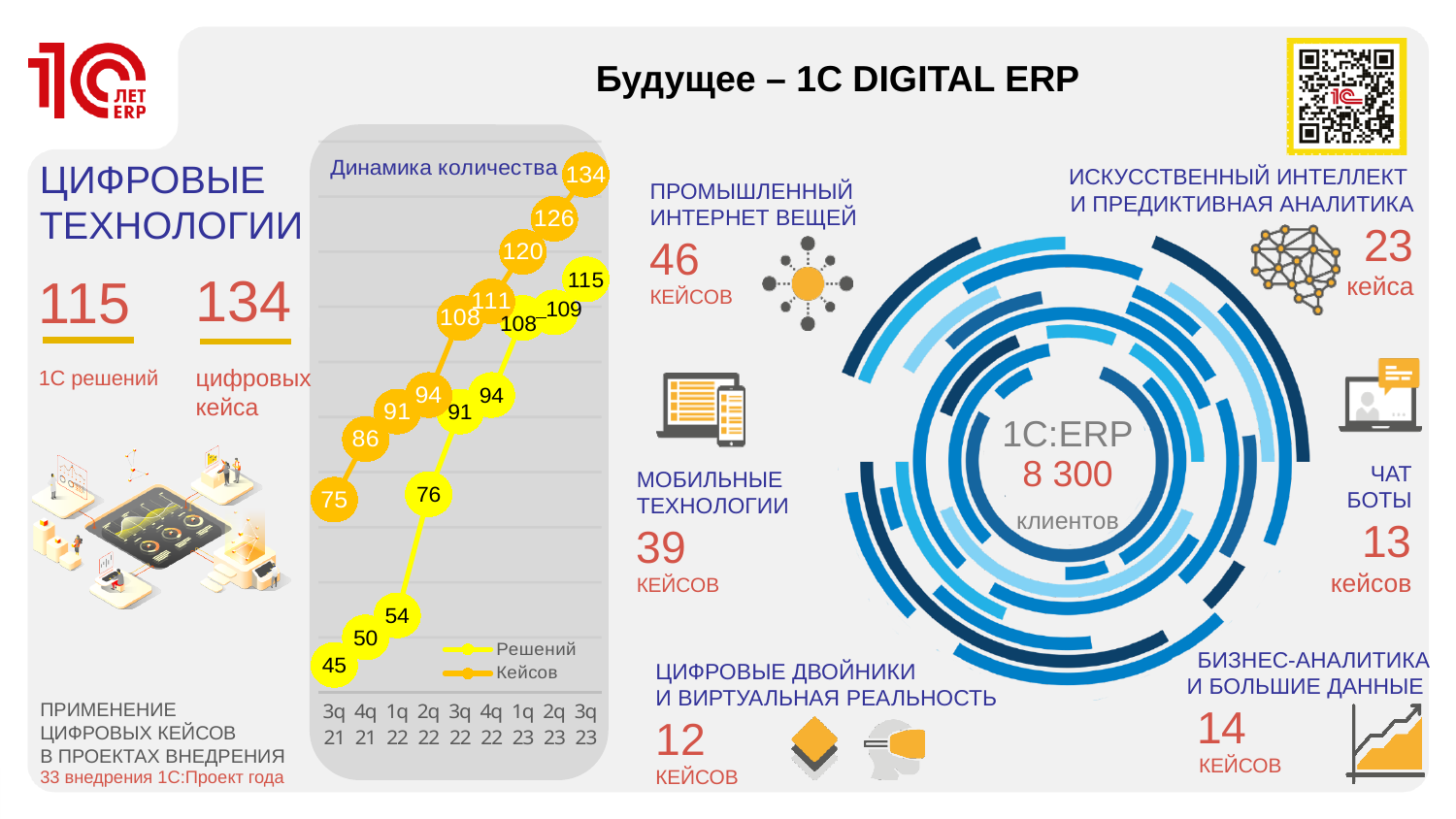
In the 'Динамика количества' chart, do the 'Решений' values rise or fall from 3q 21 to 3q 23? rise What type of chart is 'Динамика количества'? line chart In the 'Динамика количества' chart, which period has the highest 'Решений' value? 3q 23 In the 'Динамика количества' chart, which is larger for 1q 22: 'Кейсов' or 'Решений'? Кейсов In the 'Динамика количества' chart, what is the value of 'Кейсов' for 4q 22? 111 In the 'Динамика количества' chart, what is the difference between 'Кейсов' and 'Решений' for 3q 23? 19 In the 'Динамика количества' chart, what is the value of 'Решений' for 3q 21? 45 In the 'Динамика количества' chart, what is the value of 'Решений' for 2q 22? 76 In the 'Динамика количества' chart, what is the value of 'Кейсов' for 3q 23? 134 In the 'Динамика количества' chart, which period has the lowest 'Кейсов' value? 3q 21 How many time periods are shown on the x axis of the 'Динамика количества' chart? 9 How many series does the legend of the 'Динамика количества' chart list? 2